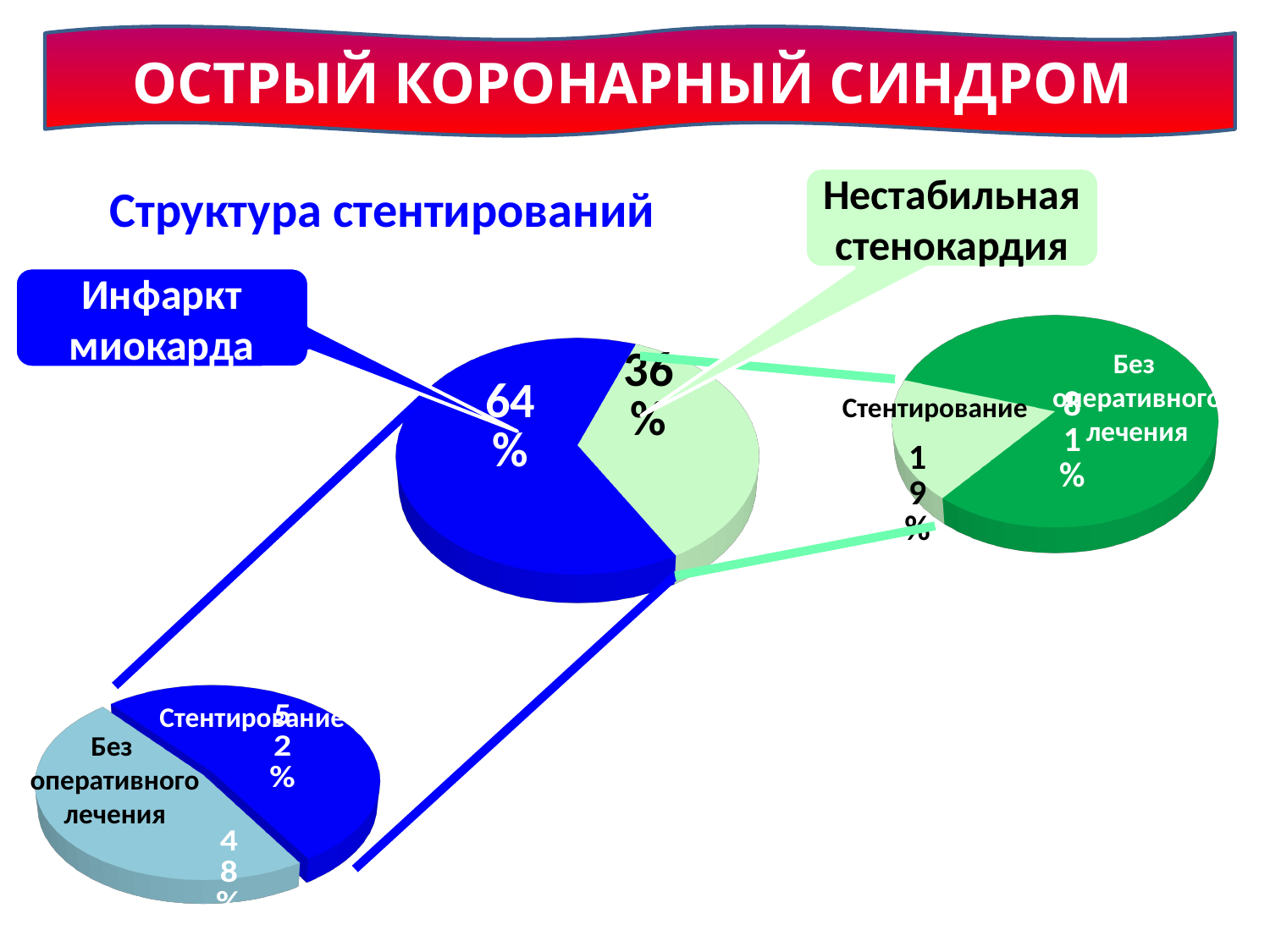
In the central pie chart 'Структура стентирований', what is the difference between the 'Инфаркт миокарда' and 'Нестабильная стенокардия' shares? 28% Which is larger: the 'Стентирование' share in the bottom-left pie chart or the 'Стентирование' share in the right pie chart? bottom-left pie chart In the central pie chart 'Структура стентирований', what share is labelled for 'Инфаркт миокарда'? 64% What type of chart is the central chart 'Структура стентирований'? pie chart In the right pie chart, what share is labelled for 'Стентирование'? 19% In the right pie chart, what share is labelled for 'Без оперативного лечения'? 81% In the central pie chart 'Структура стентирований', what share is labelled for 'Нестабильная стенокардия'? 36% How many pie charts are shown on the slide? 3 In the bottom-left pie chart, what share is labelled for 'Без оперативного лечения'? 48% In the central pie chart 'Структура стентирований', which category has the larger slice? Инфаркт миокарда In the right pie chart, which category has the smaller slice? Стентирование In the bottom-left pie chart, what share is labelled for 'Стентирование'? 52%